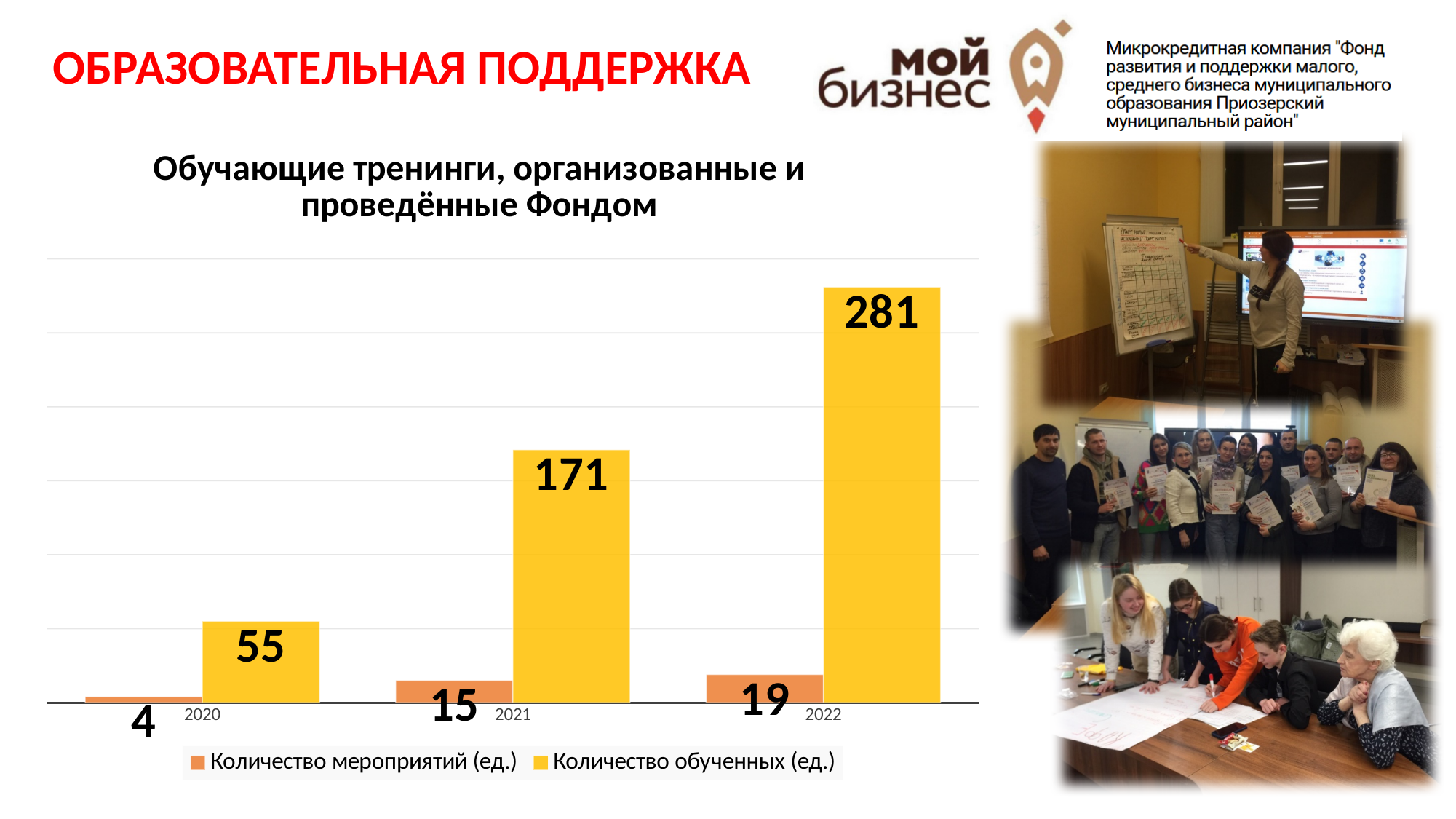
What is the value of Количество обученных (ед.) for 2021? 171 Which year has the highest value for Количество обученных (ед.)? 2022 What is the value of Количество мероприятий (ед.) for 2020? 4 Does Количество обученных (ед.) rise or fall from 2020 to 2022? Rise How many years are shown on the x axis? 3 What is the value of Количество обученных (ед.) for 2022? 281 Which year has the lowest value for Количество мероприятий (ед.)? 2020 Which is larger: Количество мероприятий (ед.) in 2021 or in 2022? 2022 How many series does the legend list? 2 What is the difference between Количество обученных (ед.) in 2022 and in 2021? 110 What kind of chart is shown on the slide? Bar chart What is the value of Количество мероприятий (ед.) for 2021? 15